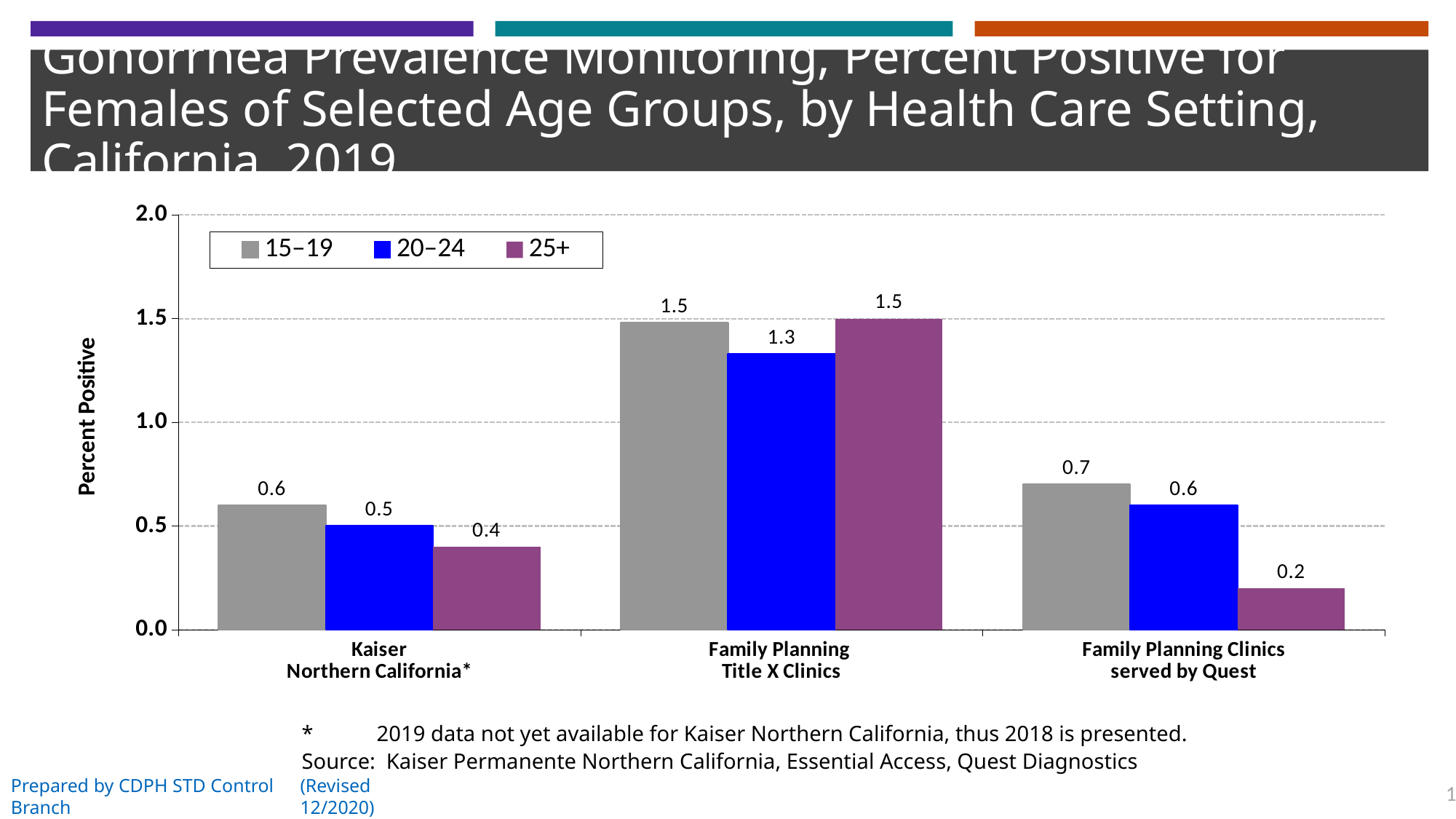
What is the percent positive for the 15–19 age group at Family Planning Title X Clinics? 1.5 What is the percent positive for the 25+ age group at Family Planning Clinics served by Quest? 0.2 Which health care setting has the highest percent positive for the 20–24 age group? Family Planning Title X Clinics Which health care setting has the lowest percent positive for the 25+ age group? Family Planning Clinics served by Quest What is the label of the y axis? Percent Positive How many health care settings are shown on the x axis? 3 Is the value for the 20–24 age group at Family Planning Title X Clinics greater or less than 1.0? greater What is the difference between the 15–19 and 20–24 percent positive values at Family Planning Title X Clinics? 0.2 What type of chart is shown on the slide? bar chart Is the percent positive for the 15–19 age group higher at Kaiser Northern California or at Family Planning Clinics served by Quest? Family Planning Clinics served by Quest What is the percent positive for the 20–24 age group at Kaiser Northern California? 0.5 How many age groups does the legend list? 3